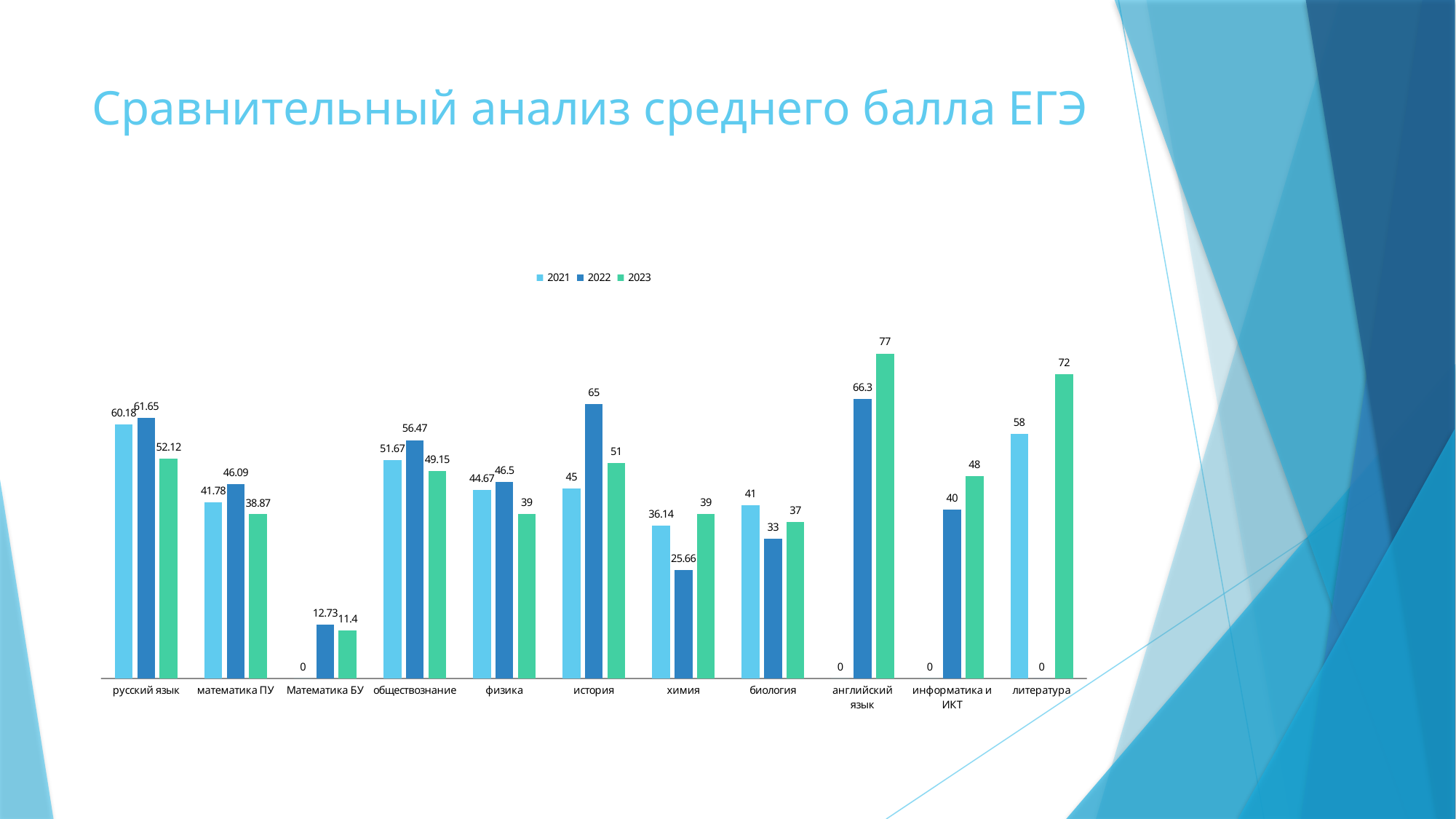
What is the value for 2021 for обществознание? 51.67 What is the title of the slide? Сравнительный анализ среднего балла ЕГЭ What is the value for 2023 for английский язык? 77 Which category has the lowest non-zero value for 2022? Математика БУ How many series does the legend list? 3 Which is larger for биология: the 2021 value or the 2023 value? 2021 What kind of chart is shown on the slide? bar chart How many categories are shown on the x axis? 11 Which category has the highest value for 2023? английский язык What is the difference between the 2022 and 2021 values for история? 20 What is the value for 2022 for химия? 25.66 What is the value for 2022 for история? 65